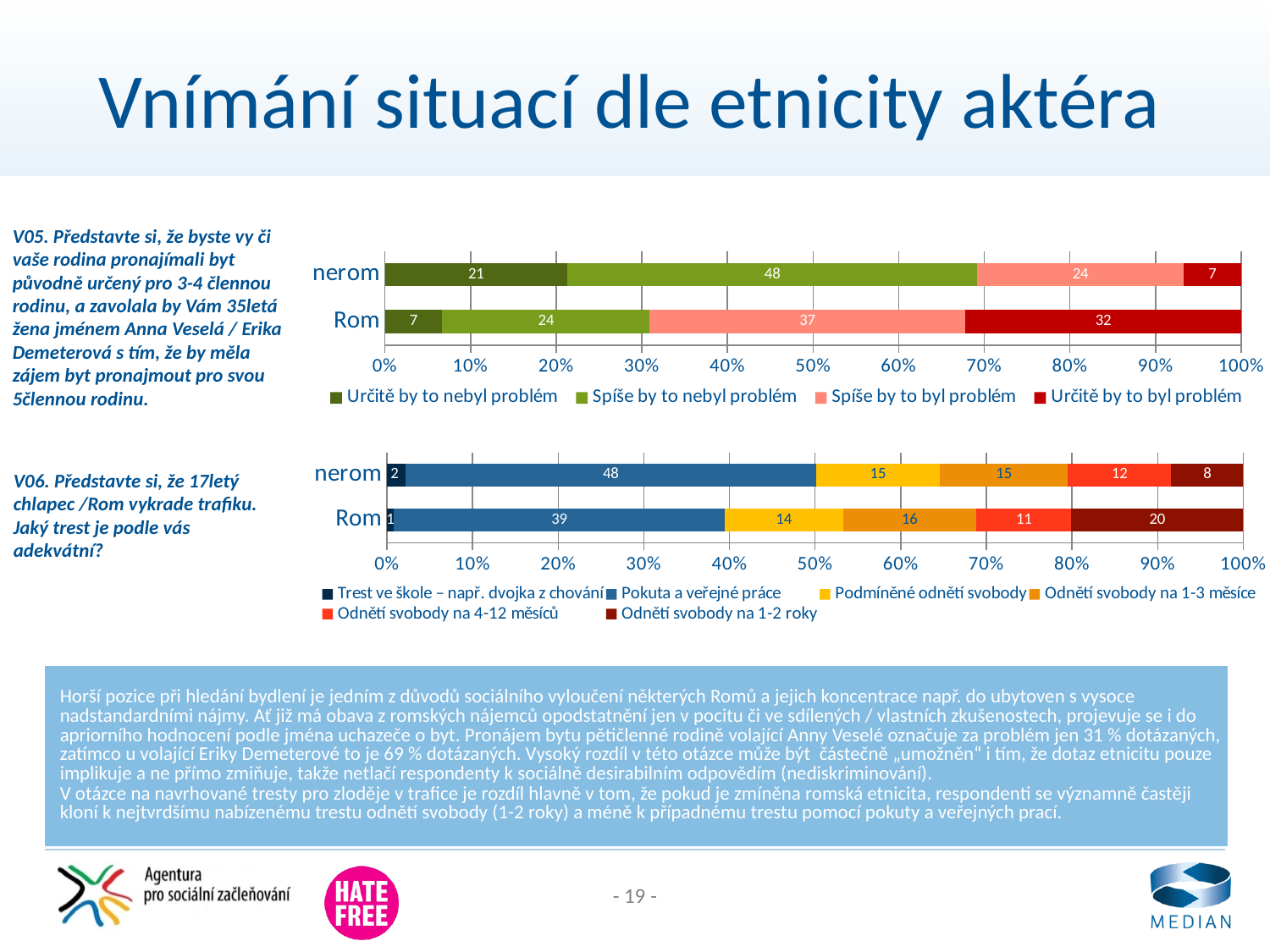
In the top chart, what is the difference between the "Určitě by to nebyl problém" values for nerom and Rom? 14 How many categories are shown on the y axis of the bottom chart? 2 In the bottom chart, what is the value of "Odnětí svobody na 1-2 roky" for Rom? 20 What kind of chart is the top chart? Stacked bar chart How many series does the legend of the top chart list? 4 In the bottom chart, what is the difference between the "Odnětí svobody na 1-2 roky" values for Rom and nerom? 12 How many series does the legend of the bottom chart list? 6 In the bottom chart, what is the value of "Pokuta a veřejné práce" for nerom? 48 In the top chart, what is the value of "Spíše by to nebyl problém" for nerom? 48 In the bottom chart, which segment is the largest for Rom? Pokuta a veřejné práce In the top chart, which category has the larger value for "Spíše by to byl problém", nerom or Rom? Rom In the top chart, what is the value of "Určitě by to byl problém" for Rom? 32